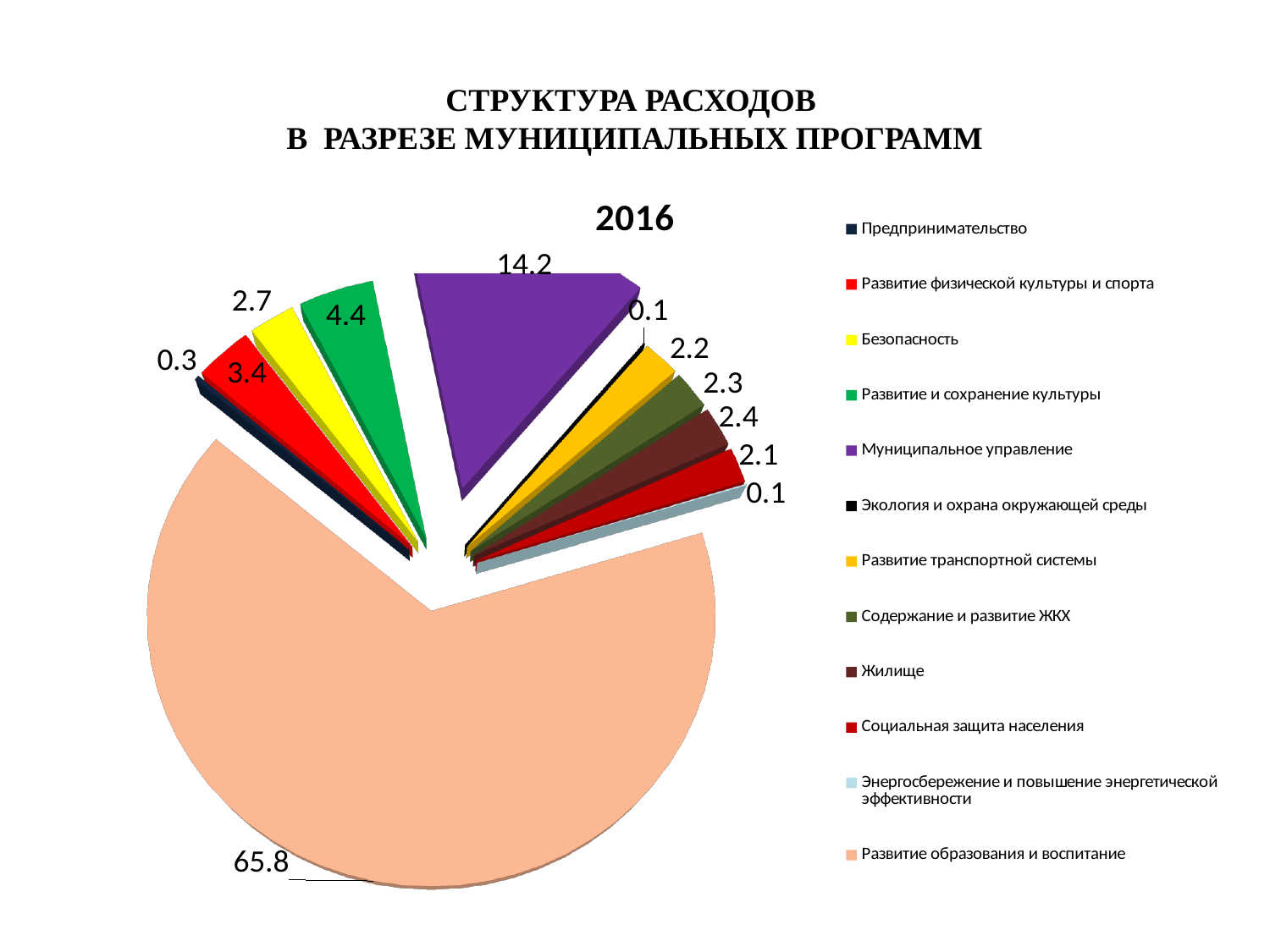
Which is larger: the value for Развитие и сохранение культуры or the value for Развитие физической культуры и спорта? Развитие и сохранение культуры What is the value shown for Безопасность? 2.7 What is the value shown for Предпринимательство? 0.3 What is the value shown for Жилище? 2.4 What is the value shown for Развитие образования и воспитание? 65.8 How many categories does the legend list? 12 What is the value shown for Муниципальное управление? 14.2 Which category has the largest slice of the pie? Развитие образования и воспитание What year is shown as the title above the pie chart? 2016 What kind of chart is shown on the slide? pie chart What is the value shown for Развитие и сохранение культуры? 4.4 What is the difference between the values for Развитие образования и воспитание and Муниципальное управление? 51.6